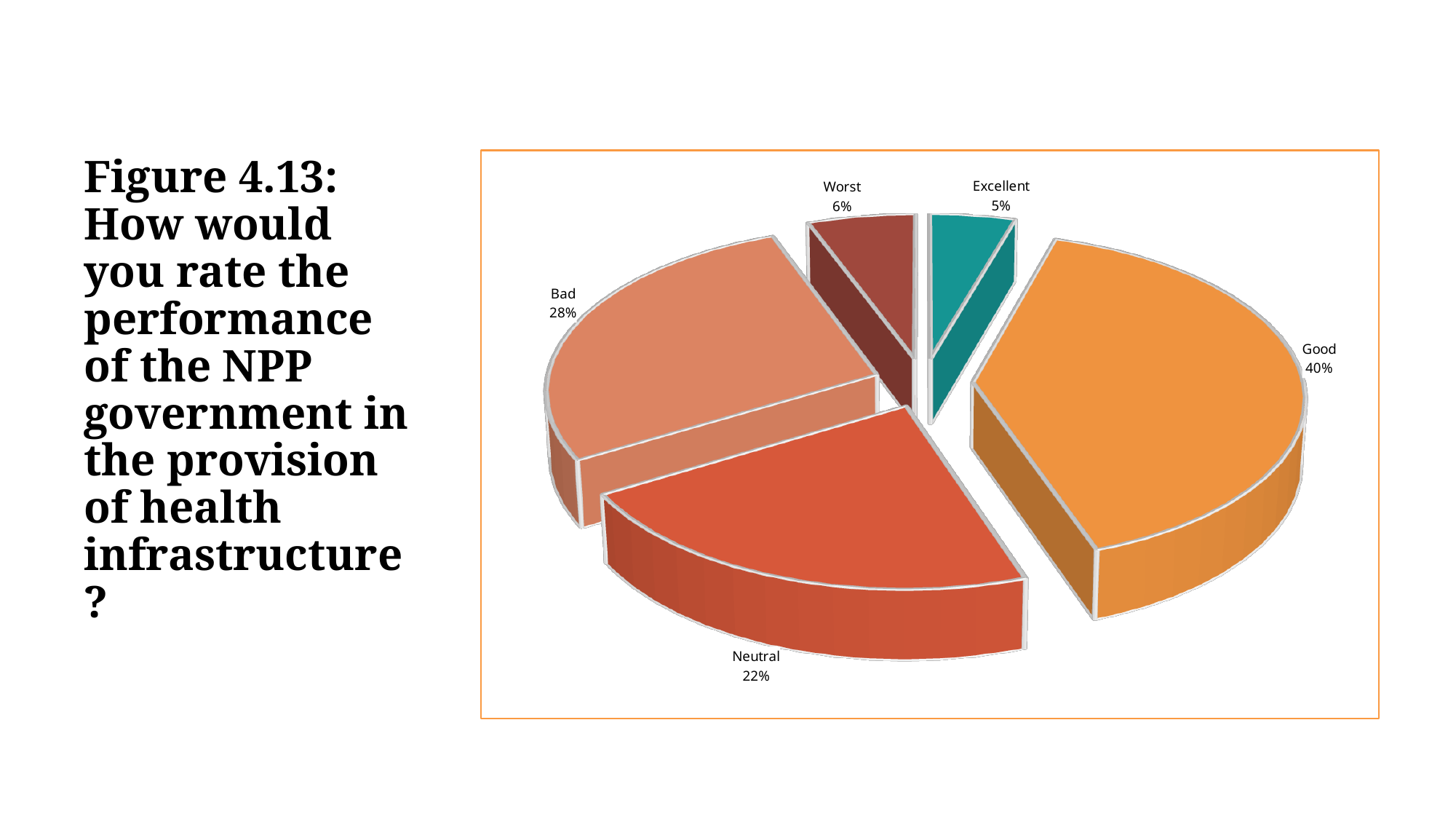
What is the combined share of the Good and Excellent slices? 45% What percentage of respondents rated the performance as Bad? 28% What is the difference in percentage points between the Good and Bad slices? 12 How many categories are shown in the pie chart? 5 Which rating category has the smallest share of the pie? Excellent Which is larger, the Bad slice or the Neutral slice? Bad What percentage of respondents rated the NPP government's performance as Good? 40% What percentage of respondents rated the performance as Excellent? 5% Which rating category has the largest share of the pie? Good What percentage of respondents gave a Neutral rating? 22% What percentage of respondents rated the performance as Worst? 6% What kind of chart is shown on the slide? pie chart